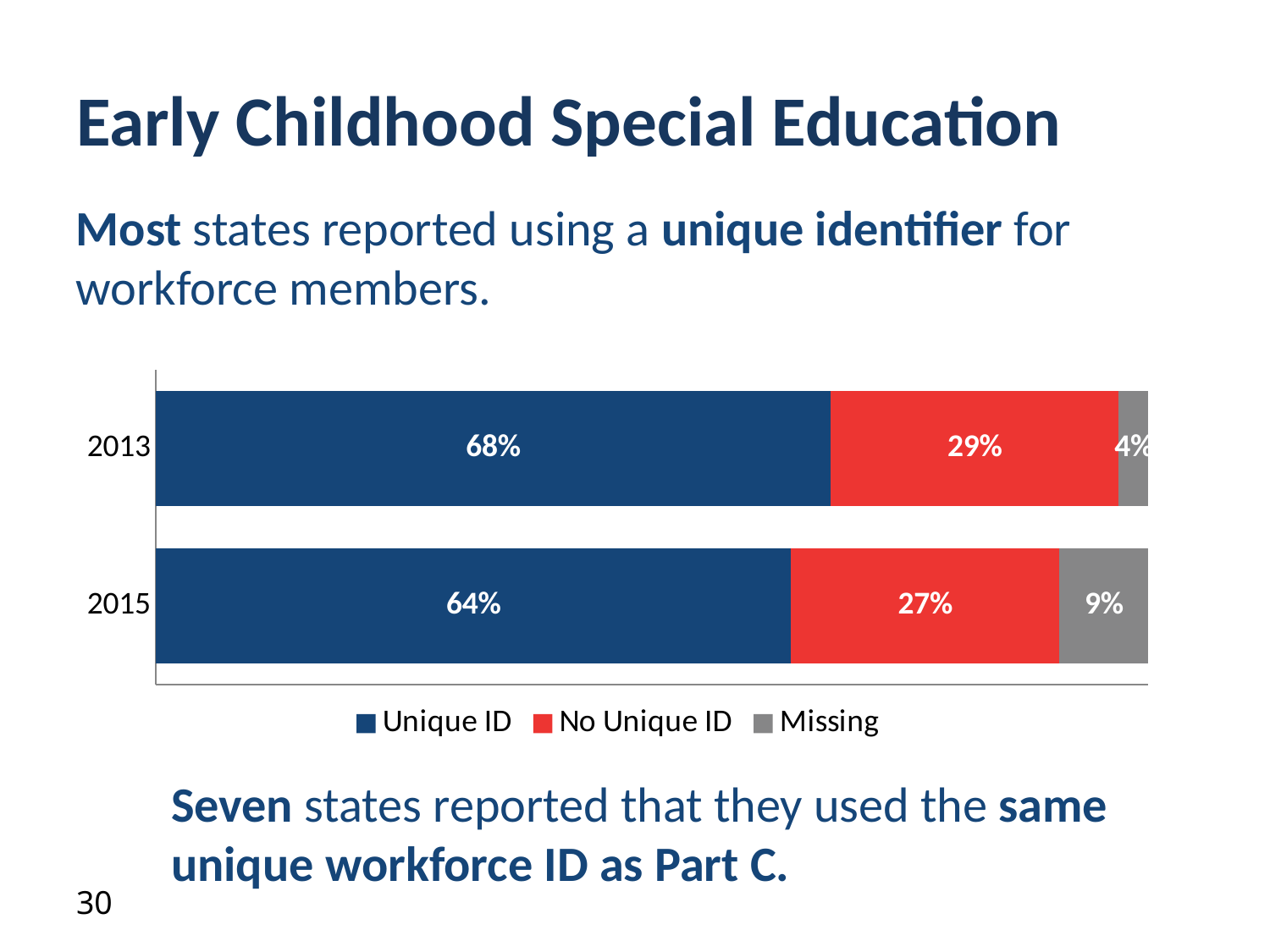
What kind of chart is shown on the slide? Stacked bar chart What is the Missing value for 2013? 4% What is the difference between the Unique ID percentages for 2013 and 2015? 4% How many series does the legend list? 3 What is the difference between the No Unique ID percentages for 2013 and 2015? 2% How many years are shown on the chart? 2 What is the Missing value for 2015? 9% Which year has the higher Unique ID percentage? 2013 What is the No Unique ID value for 2015? 27% What percentage of states reported using a Unique ID in 2013? 68% What percentage of states reported using a Unique ID in 2015? 64% Which year has the higher Missing percentage? 2015